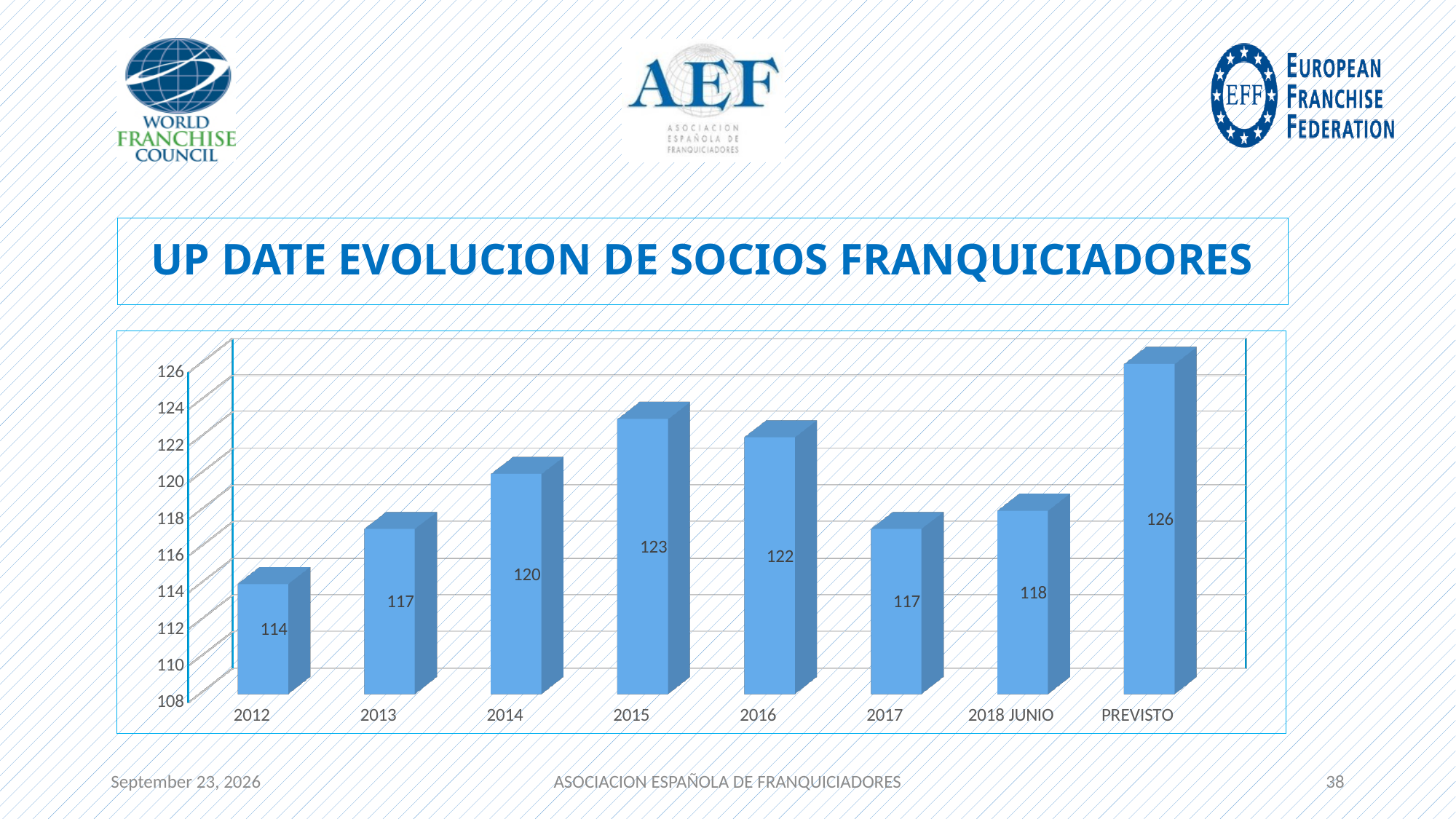
What is the value for 2018 JUNIO? 118 What is the value for 2015? 123 What is the value for 2012? 114 What is the value for PREVISTO? 126 Do the values rise or fall from 2012 to 2015? Rise Which category has the highest value? PREVISTO Which is larger, the value for 2014 or the value for 2017? 2014 What is the difference between the values for PREVISTO and 2018 JUNIO? 8 Which category has the lowest value? 2012 What kind of chart is shown on the slide? Bar chart How many categories are shown on the x axis? 8 What is the difference between the values for 2015 and 2012? 9